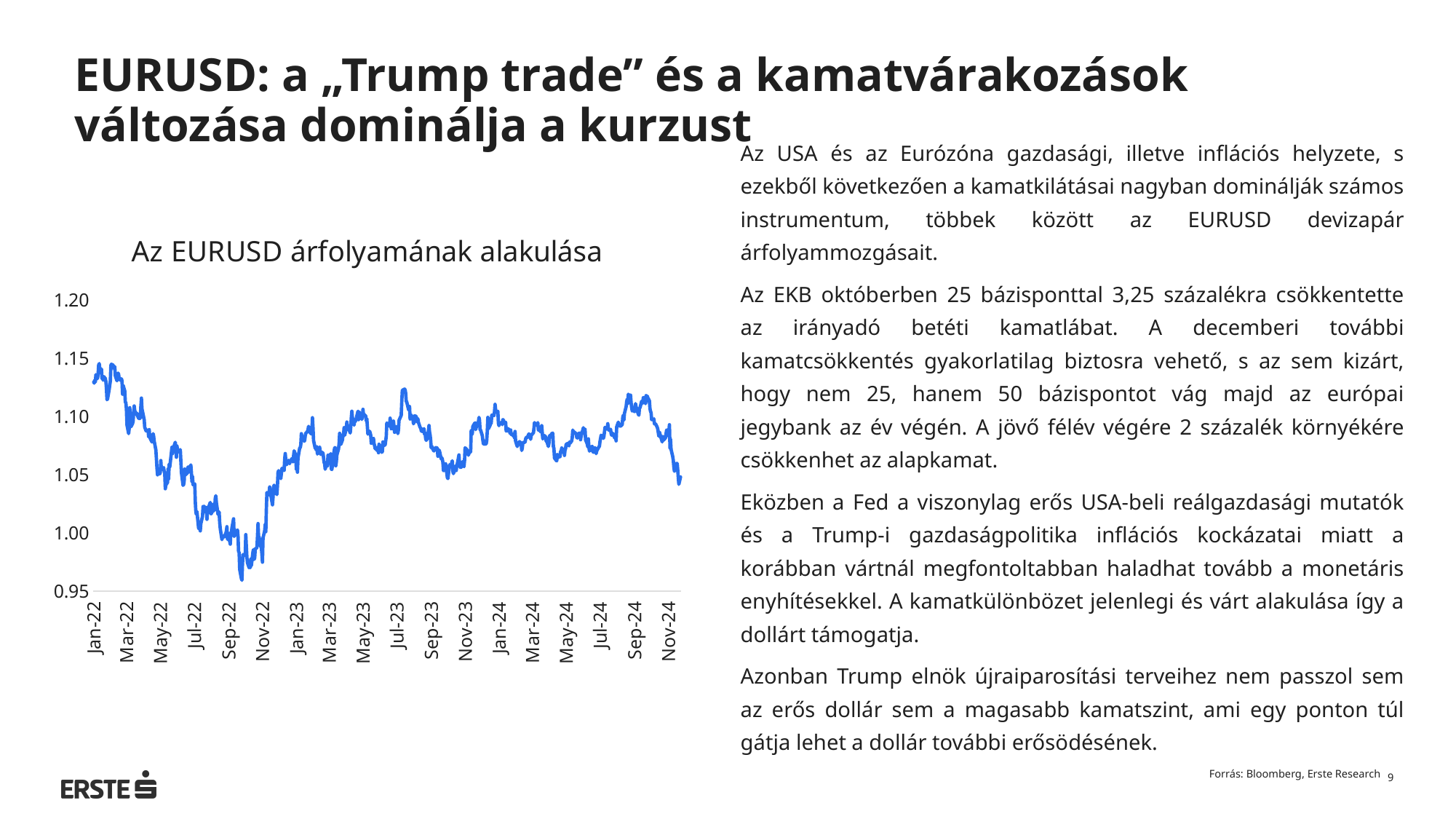
What is the title of the chart on the slide? Az EURUSD árfolyamának alakulása What is the highest value shown on the y axis of the chart? 1.20 Is the EURUSD value at Jan-22 greater or less than 1.10? greater How many date labels are shown on the x axis of the chart? 18 Does the EURUSD line rise or fall between Jan-22 and Sep-22? fall Does the EURUSD line rise or fall between Sep-22 and Jul-23? rise Is the lowest EURUSD value in the chart, reached around Sep-22, greater or less than 1.00? less Around which x-axis label does the EURUSD line reach its lowest point? Sep-22 What kind of chart is shown on the slide? line chart Which is higher, the EURUSD value at Jan-22 or at Sep-22? Jan-22 Is the EURUSD value at Jul-23 greater or less than 1.05? greater